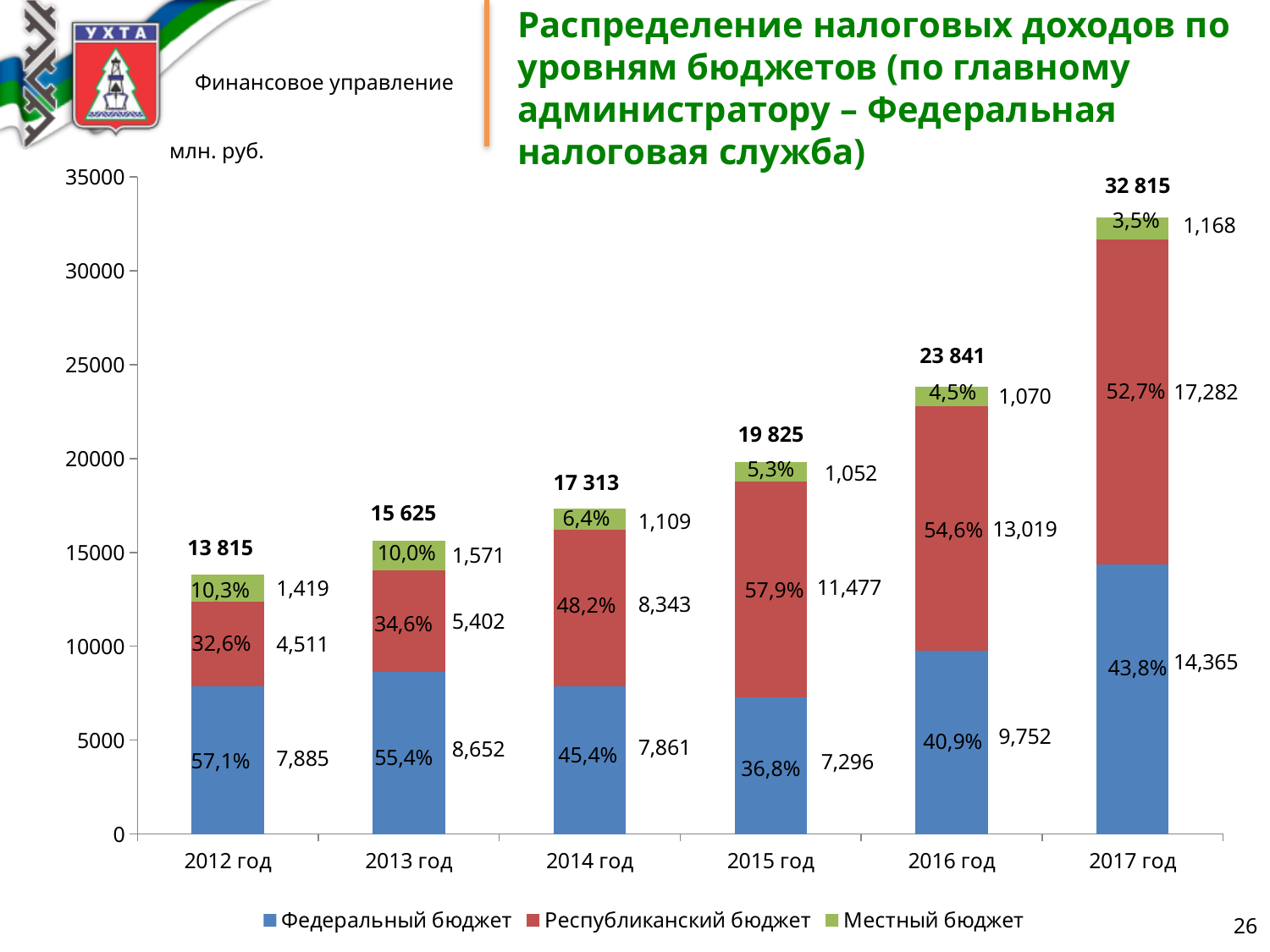
What is the value for Федеральный бюджет in 2017 год? 14,365 What share of the 2014 год total does Местный бюджет represent, as printed on the slide? 6,4% What is the value for Республиканский бюджет in 2015 год? 11,477 How many years are shown on the x axis? 6 How many series does the legend list? 3 What type of chart is shown on the slide? stacked bar chart What is the value for Местный бюджет in 2013 год? 1,571 Which year has the highest total tax revenue? 2017 год What is the total of the stacked bar for 2016 год? 23 841 Which year has the lowest total tax revenue? 2012 год Which is larger: Федеральный бюджет in 2013 год or Федеральный бюджет in 2015 год? 2013 год What is the difference between the Республиканский бюджет values for 2017 год and 2016 год? 4,263